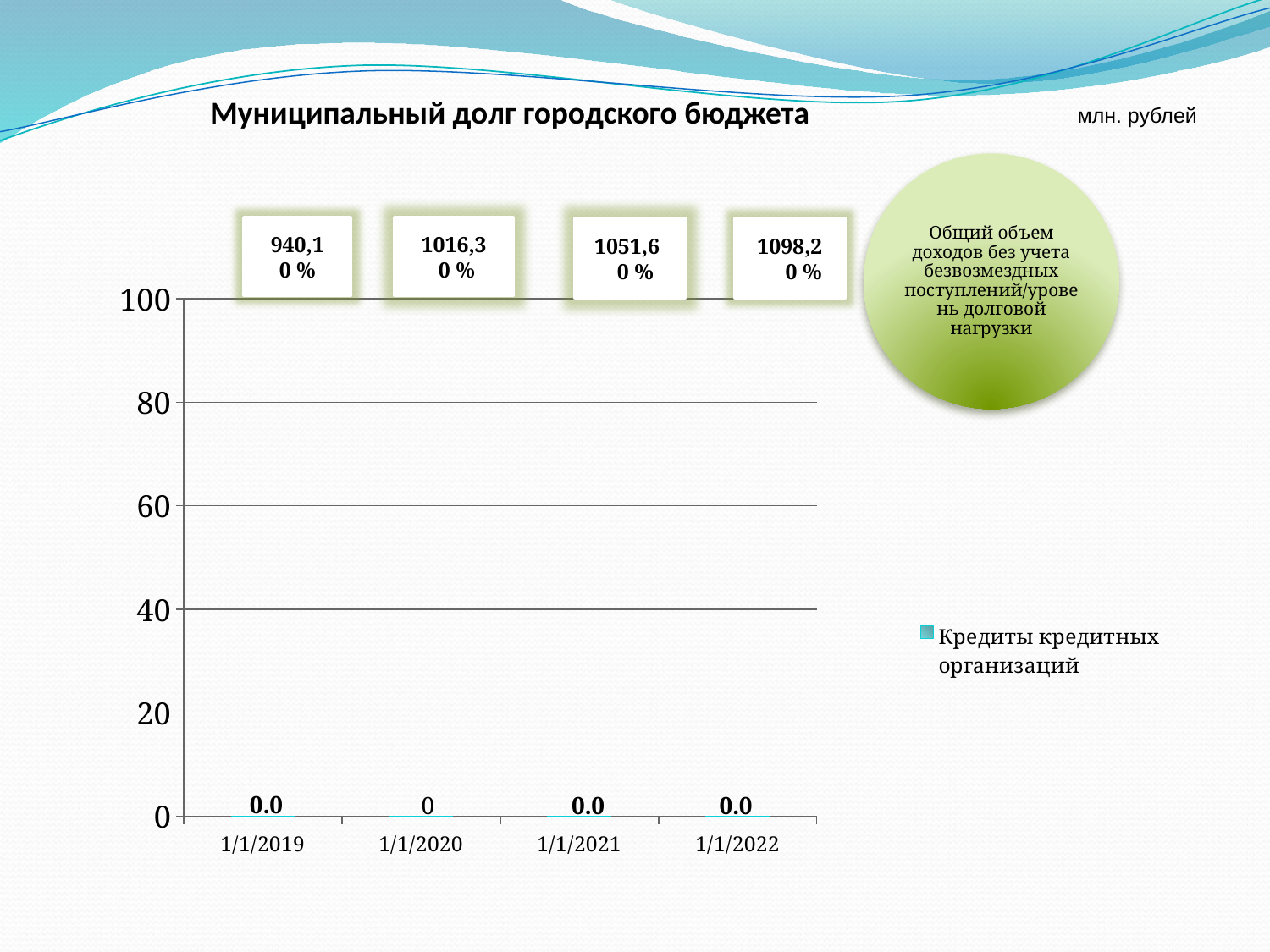
What is the value for 1/1/2019 in the chart? 0.0 What is the title of the chart? Муниципальный долг городского бюджета How many series does the legend list? 1 What is the value for 1/1/2022? 0.0 What is the highest tick value shown on the y axis? 100 Is the value for 1/1/2022 greater or less than 20? less What is the data label shown for 1/1/2020? 0 What kind of chart is shown on the slide? bar chart Do the plotted values rise, fall, or stay the same from 1/1/2019 to 1/1/2022? stay the same What is the value for 1/1/2021? 0.0 What series name is listed in the legend? Кредиты кредитных организаций How many categories (dates) are shown on the x axis? 4